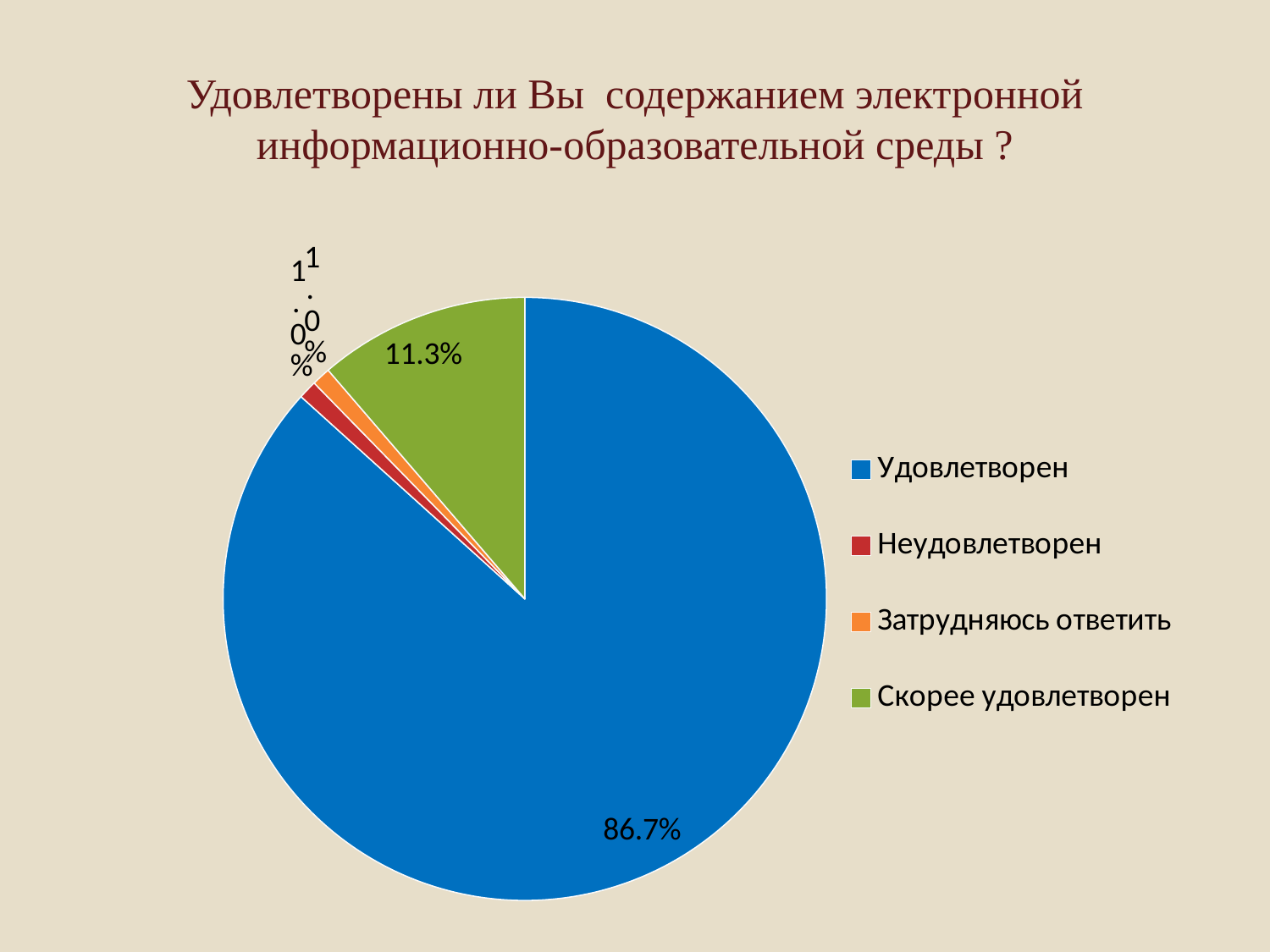
Which response category has the largest share of the pie? Удовлетворен What colour is the slice for "Скорее удовлетворен"? green What percentage of respondents answered "Скорее удовлетворен"? 11.3% What percentage of respondents answered "Удовлетворен"? 86.7% How many categories does the legend list? 4 What share of the pie does the "Скорее удовлетворен" slice represent? 11.3% What colour is the slice for "Удовлетворен"? blue What type of chart is shown on the slide? pie chart What percentage of respondents answered "Неудовлетворен"? 1.0% What is the difference in percentage points between "Удовлетворен" and "Скорее удовлетворен"? 75.4 Which is larger: the share for "Скорее удовлетворен" or the share for "Затрудняюсь ответить"? Скорее удовлетворен